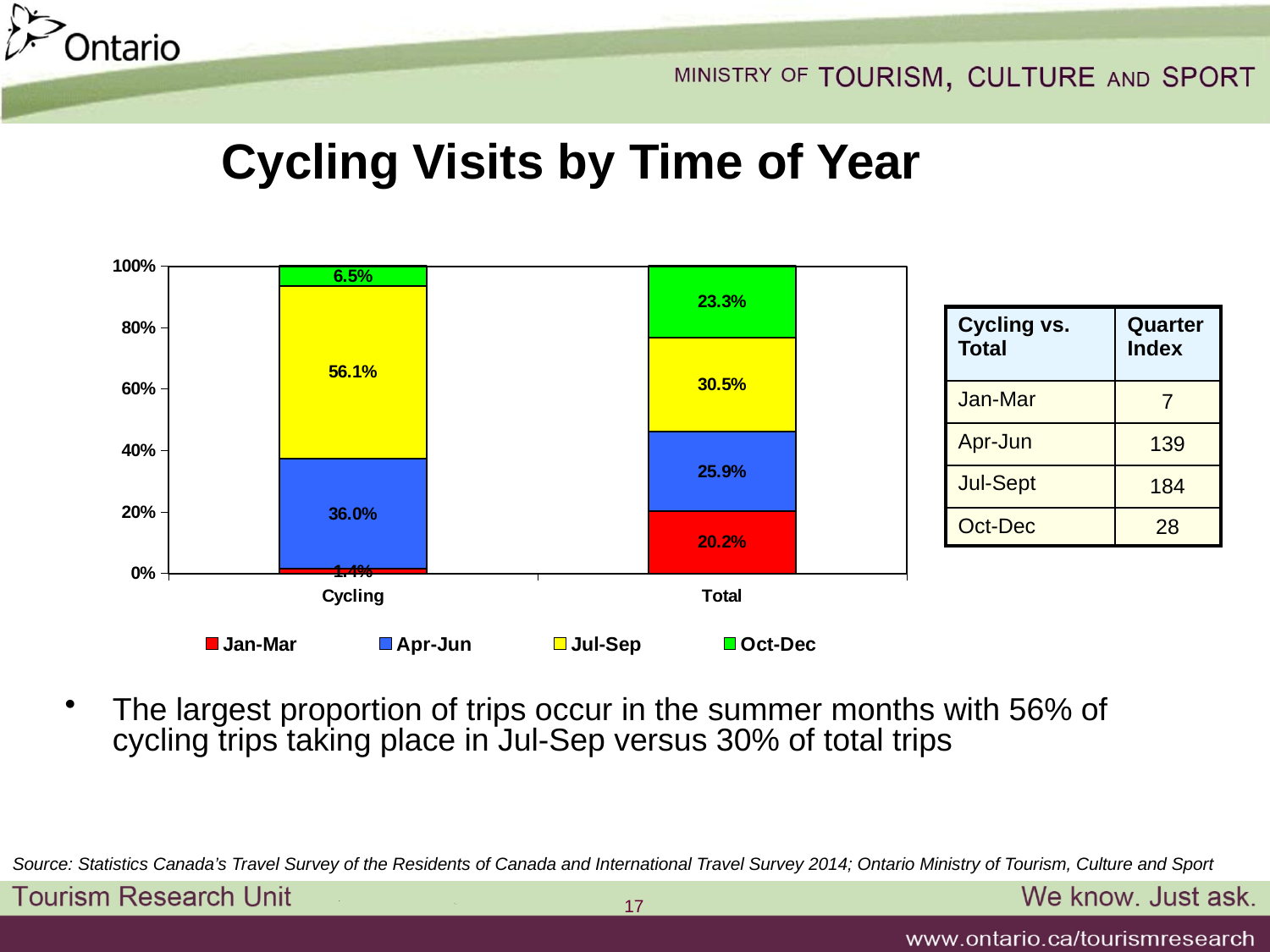
Which quarter has the largest share of the Cycling bar? Jul-Sep What kind of chart is shown on the slide? Stacked bar chart What is the Jul-Sep value for Total? 30.5% Which is larger: the Apr-Jun value for Cycling or the Apr-Jun value for Total? Cycling What is the Apr-Jun value for Cycling? 36.0% What is the difference between the Jul-Sep value for Cycling and the Jul-Sep value for Total? 25.6% What is the Jul-Sep value for Cycling? 56.1% How many series does the legend list? 4 What is the Oct-Dec value for Cycling? 6.5% What is the Jan-Mar value for Total? 20.2% Which quarter has the smallest share of the Total bar? Jan-Mar What is the Oct-Dec value for Total? 23.3%